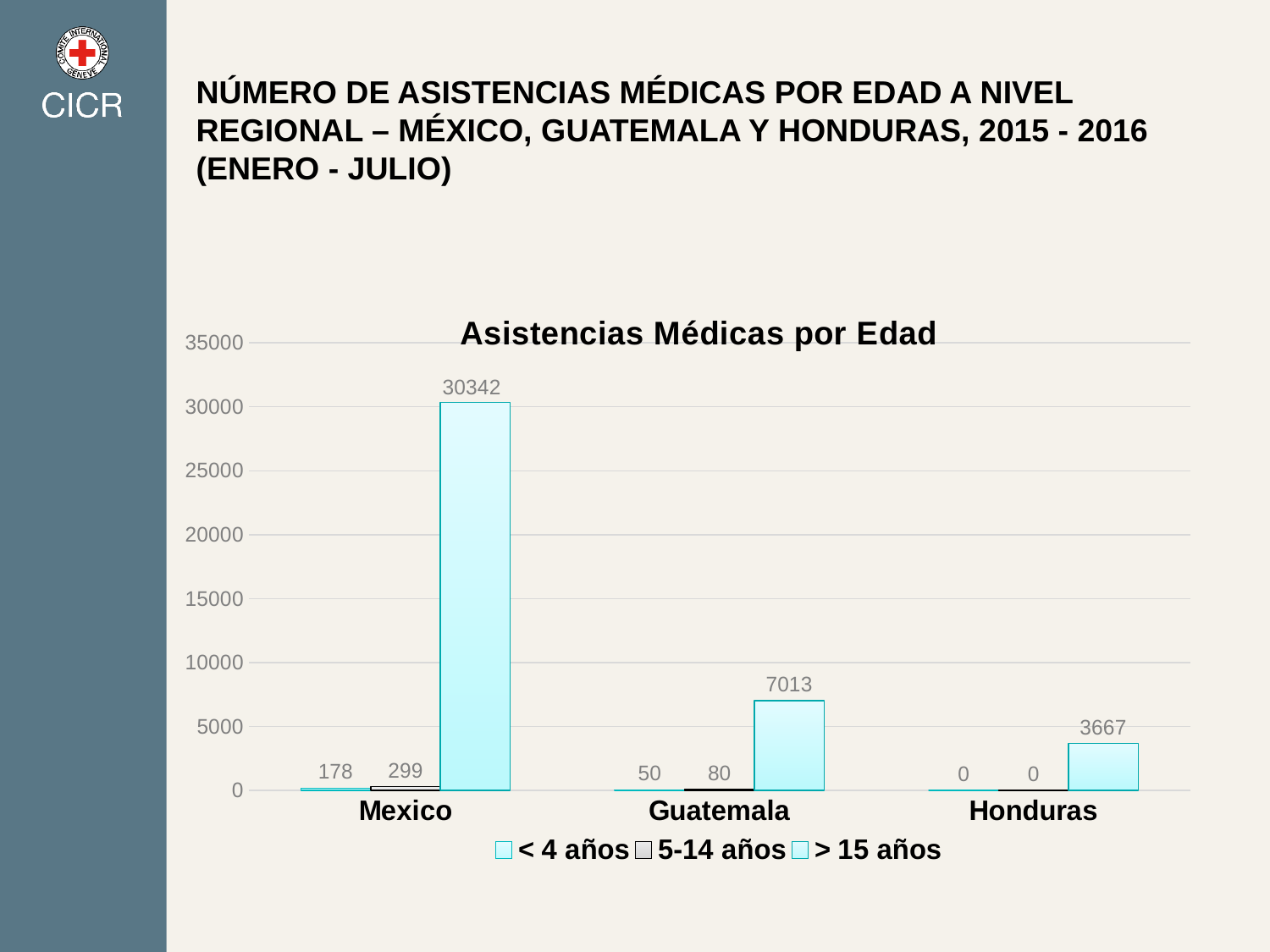
How many countries are shown on the x axis? 3 What is the title of the chart? Asistencias Médicas por Edad What kind of chart is shown? bar chart What is the value for the '< 4 años' series for Guatemala? 50 Which country has the lowest value for the '< 4 años' series? Honduras What is the value for the '> 15 años' series for Mexico? 30342 Is the '> 15 años' value for Guatemala greater or less than 5000? greater What is the value for the '5-14 años' series for Honduras? 0 Which country has the highest value for the '> 15 años' series? Mexico Which is larger: the '5-14 años' value for Mexico or the '5-14 años' value for Guatemala? Mexico How many series does the legend list? 3 What is the difference between the '> 15 años' values for Guatemala and Honduras? 3346